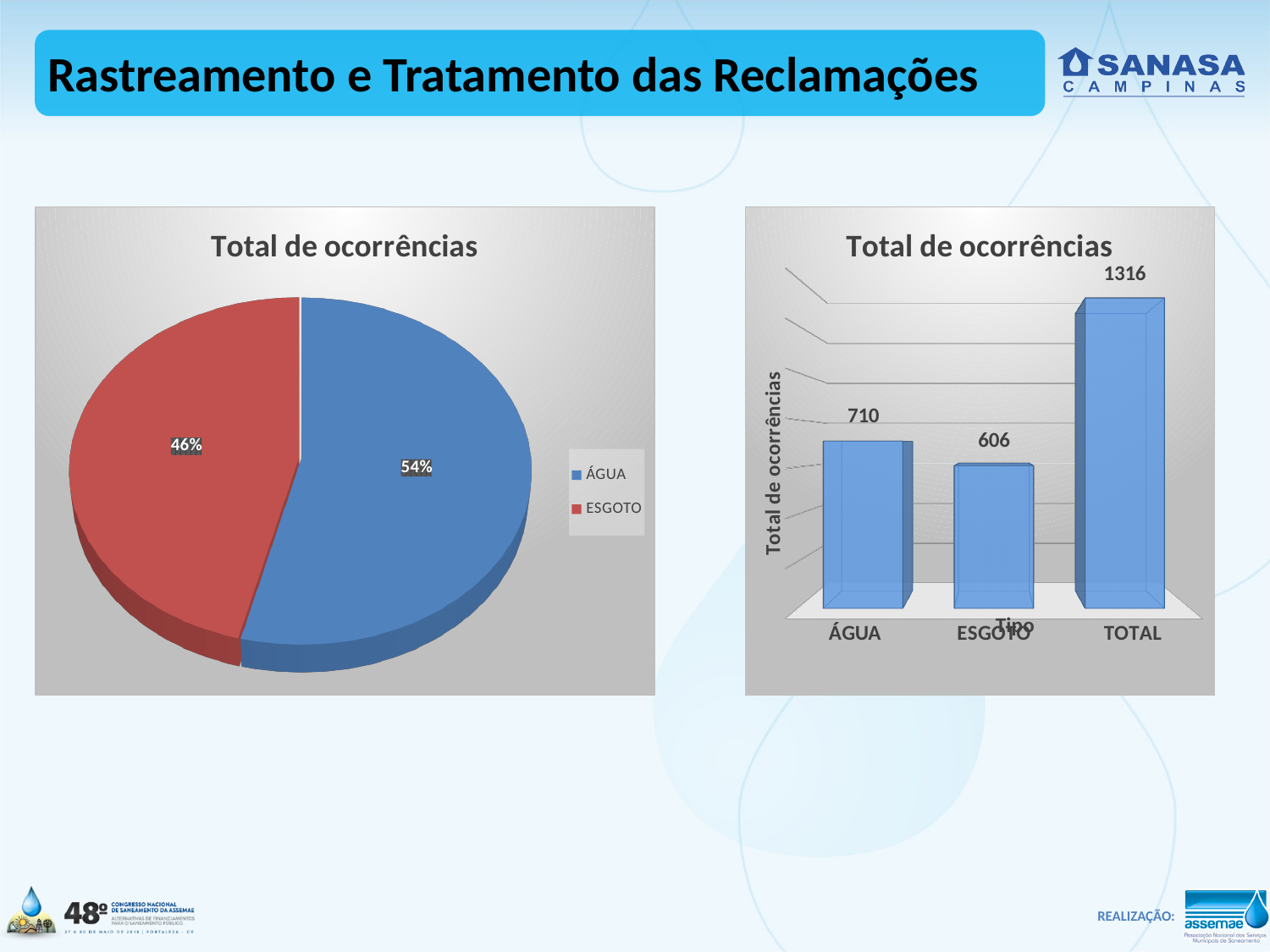
What kind of chart is the chart on the left of the slide? Pie chart In the bar chart on the right, what is the difference between the values for ÁGUA and ESGOTO? 104 In the pie chart on the left, how many categories does the legend list? 2 In the bar chart on the right, which category has the lowest value? ESGOTO In the bar chart on the right, how many bars are plotted? 3 In the bar chart on the right, what is the value for TOTAL? 1316 What kind of chart is the chart on the right of the slide? Bar chart In the bar chart on the right, what is the value for ESGOTO? 606 In the pie chart on the left, what share of occurrences is ESGOTO? 46% In the bar chart on the right, what is the value for ÁGUA? 710 In the pie chart on the left, which category has the larger slice? ÁGUA In the pie chart on the left, what share of occurrences is ÁGUA? 54%